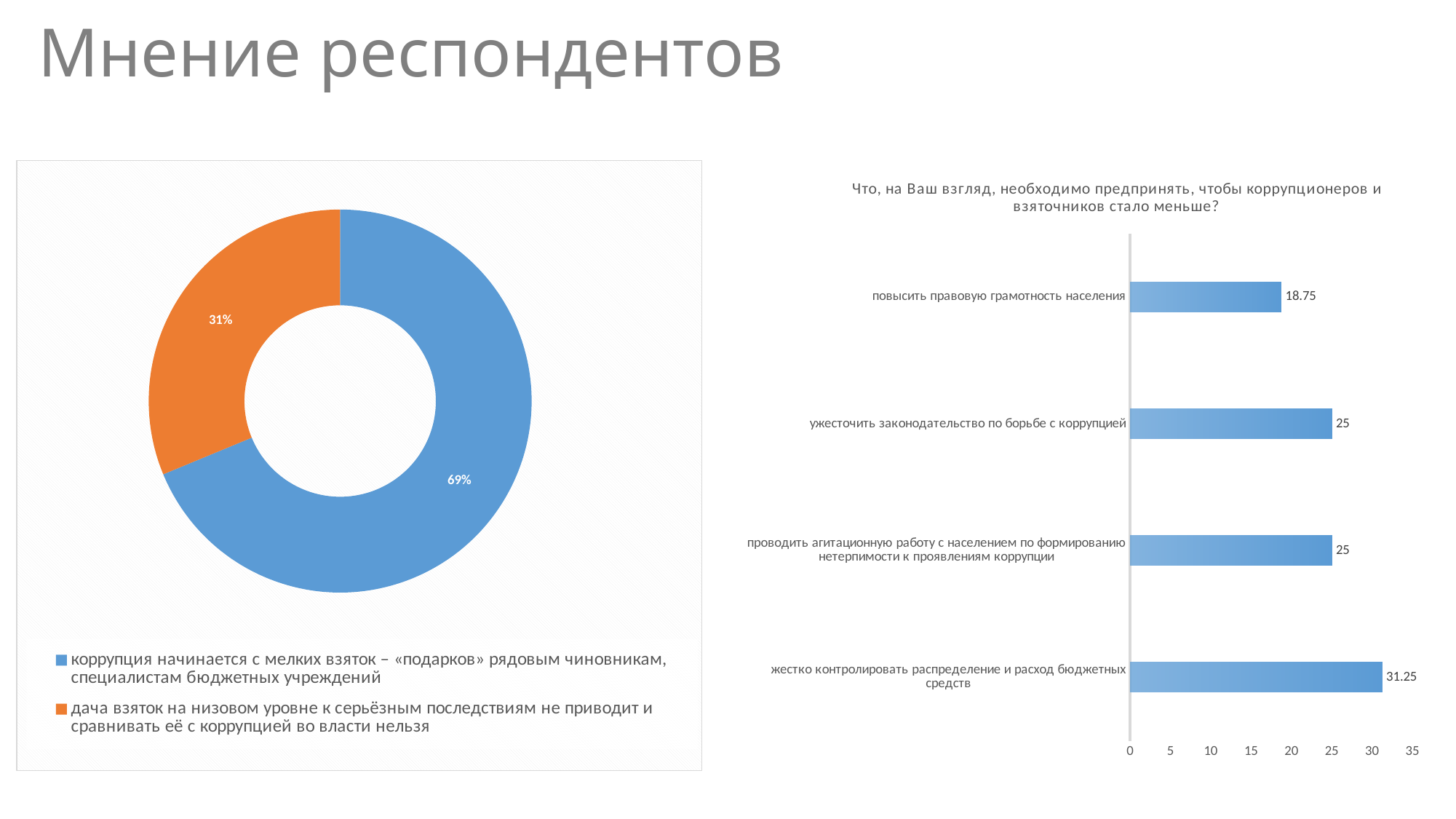
In the bar chart on the right, which category has the highest value? жестко контролировать распределение и расход бюджетных средств In the doughnut chart on the left, which segment is larger: the blue one or the orange one? the blue one How many entries does the legend of the doughnut chart on the left list? 2 In the doughnut chart on the left, what share is shown for the orange segment ("дача взяток на низовом уровне к серьёзным последствиям не приводит и сравнивать её с коррупцией во власти нельзя")? 31% In the doughnut chart on the left, what share is shown for the blue segment ("коррупция начинается с мелких взяток – «подарков» рядовым чиновникам, специалистам бюджетных учреждений")? 69% In the bar chart on the right, what is the value for "жестко контролировать распределение и расход бюджетных средств"? 31.25 In the bar chart on the right, which category has the lowest value? повысить правовую грамотность населения What kind of chart is the chart on the right of the slide? bar chart In the bar chart on the right, what is the difference between the values for "жестко контролировать распределение и расход бюджетных средств" and "повысить правовую грамотность населения"? 12.5 In the bar chart on the right, what is the value for "ужесточить законодательство по борьбе с коррупцией"? 25 In the bar chart on the right, what is the value for "повысить правовую грамотность населения"? 18.75 In the bar chart on the right, how many categories are shown? 4